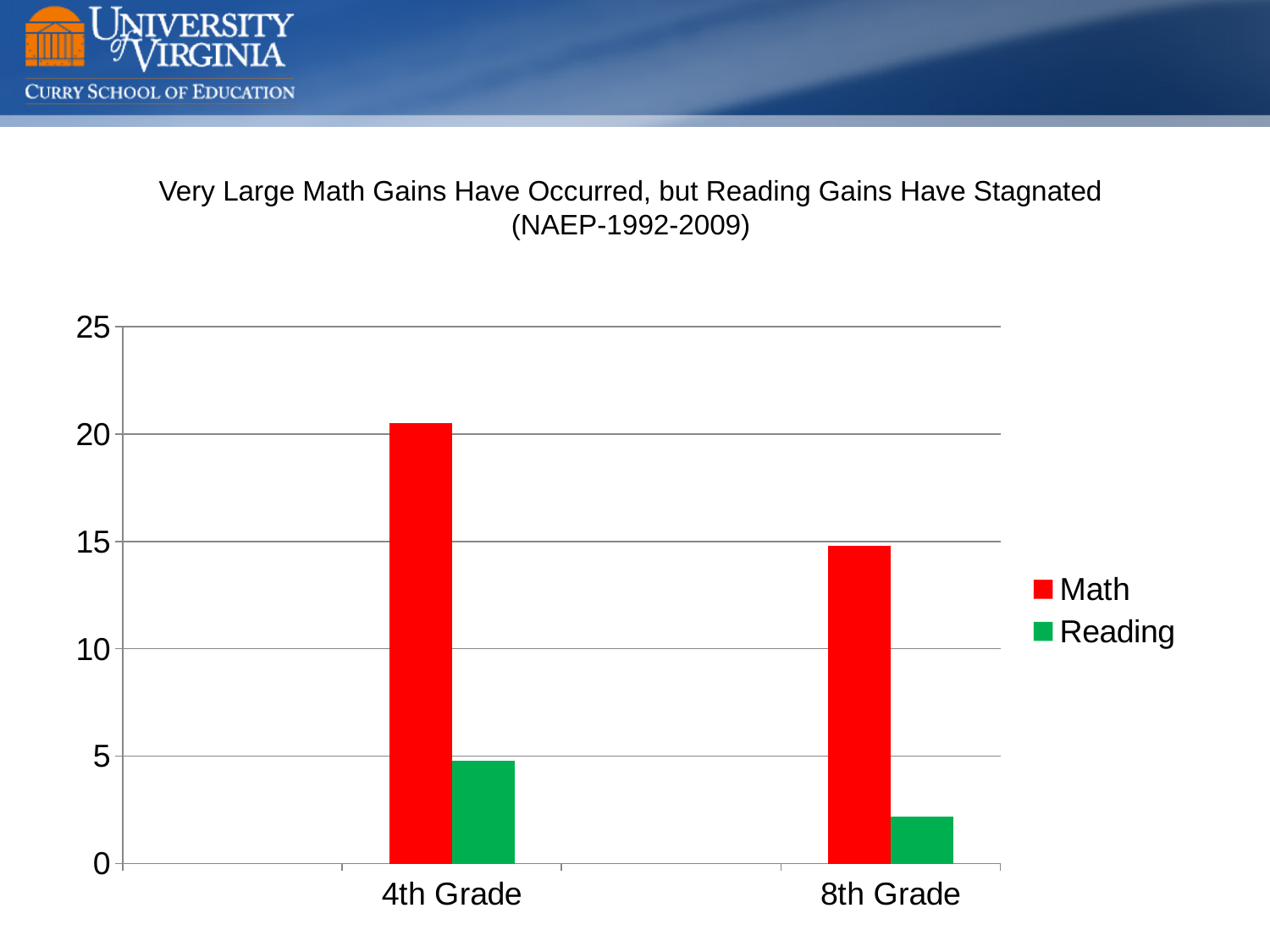
What colour are the Reading bars? green How many series does the legend list? 2 Which is larger, the Math value for 4th Grade or the Math value for 8th Grade? 4th Grade Is the Reading value for 4th Grade greater or less than 10? less Which is larger for 8th Grade, Math or Reading? Math Which bar is the tallest in the chart? 4th Grade Math What kind of chart is shown on the slide? bar chart How many grade categories are shown on the x axis? 2 Is the Math value for 8th Grade greater or less than 10? greater Which bar is the shortest in the chart? 8th Grade Reading Is the Math value for 4th Grade greater or less than 15? greater